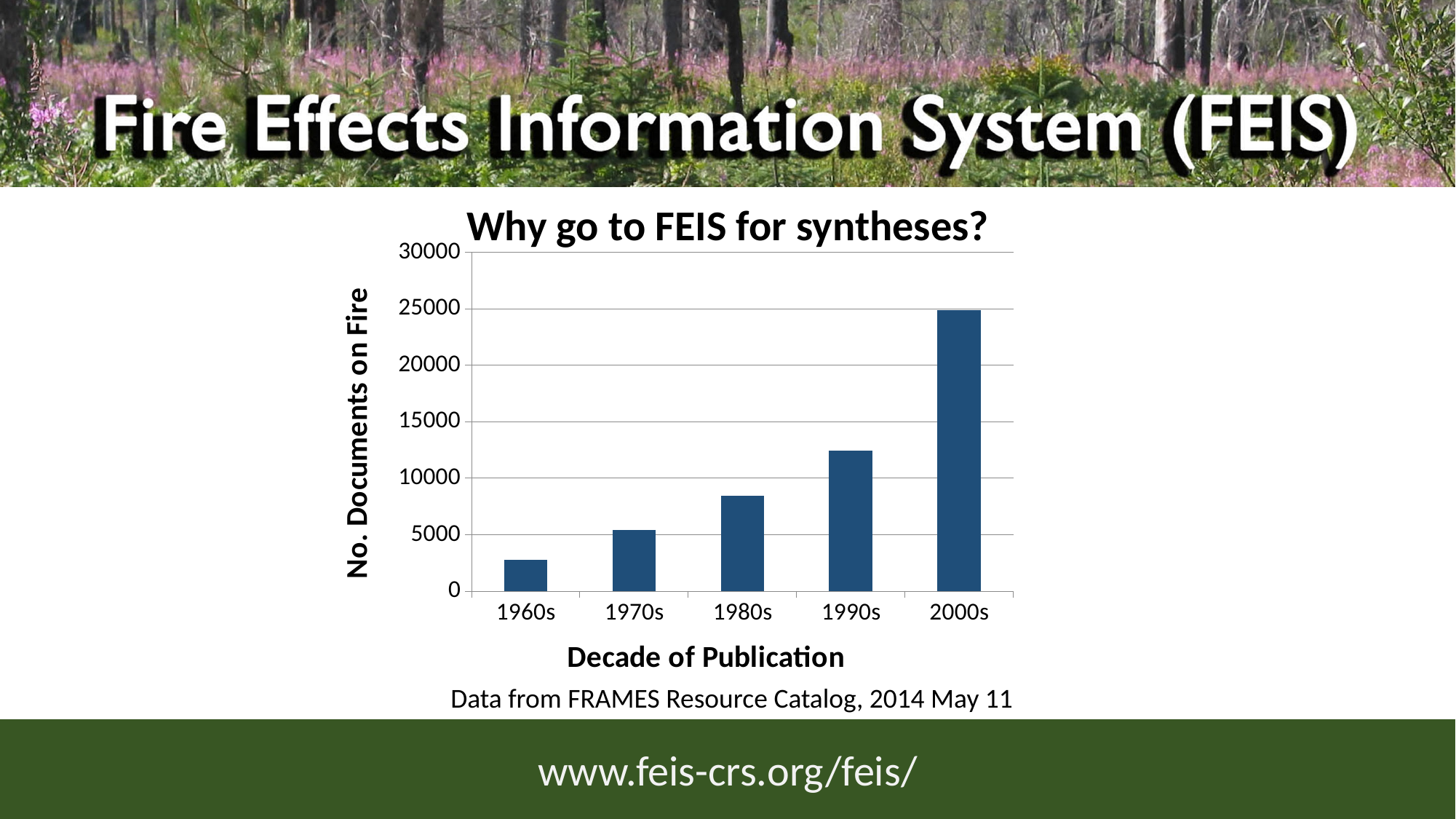
Is the value for the 1960s greater or less than 5000? less Which decade has the lowest number of documents on fire? 1960s Is the value for the 1980s greater or less than 10000? less Do the values rise or fall from the 1960s to the 2000s? rise How many decades are shown on the x axis of the chart? 5 Is the value for the 2000s greater or less than 20000? greater What is the title of the chart? Why go to FEIS for syntheses? What is the label of the y axis of the chart? No. Documents on Fire Which decade has more documents on fire, the 1980s or the 1990s? 1990s What kind of chart is shown on the slide? bar chart Which decade has the highest number of documents on fire? 2000s